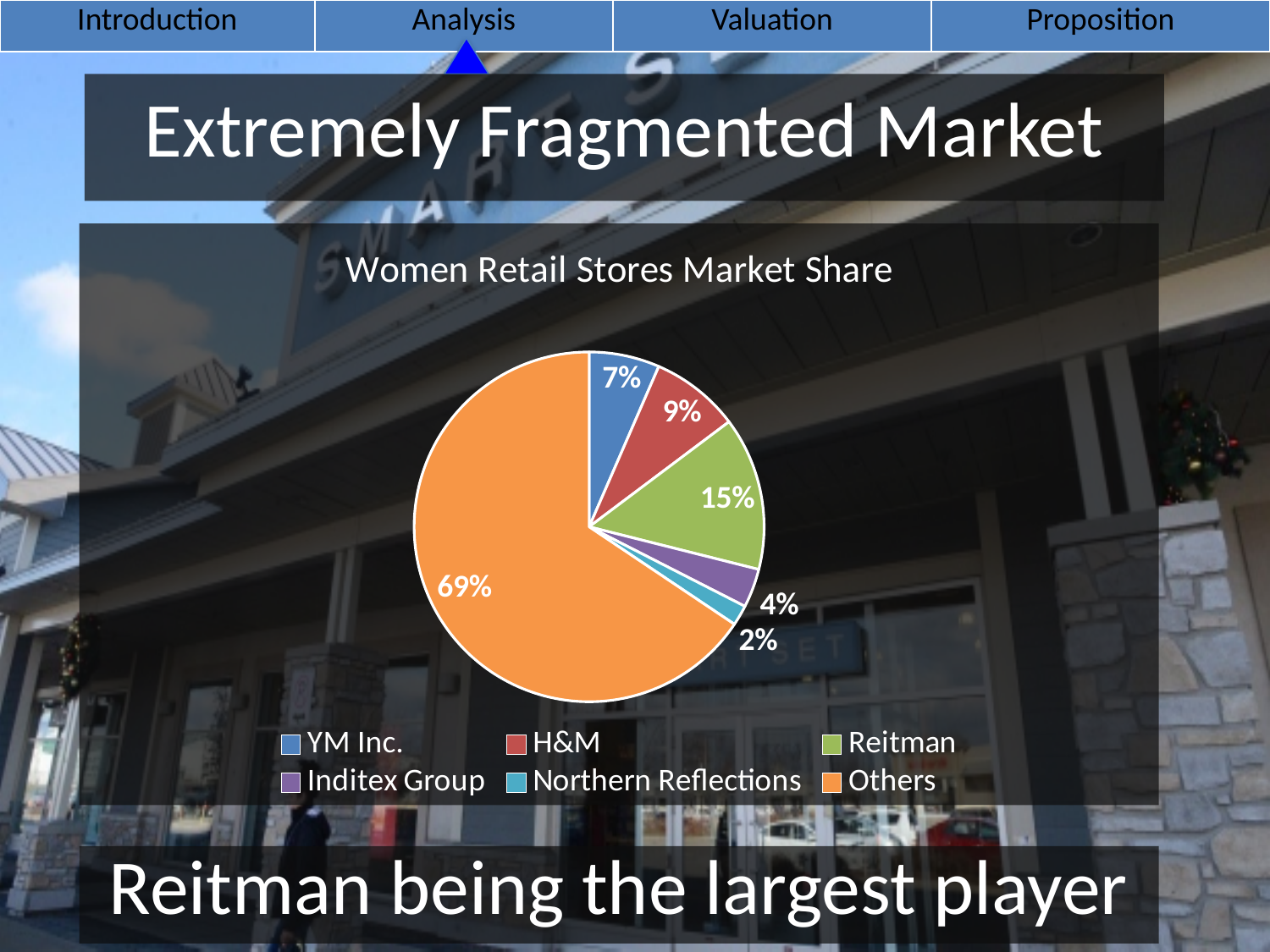
What share of the market is labelled Others? 69% What share of the market does YM Inc. hold? 7% Which category has the smallest slice of the pie? Northern Reflections Which has a larger market share, Inditex Group or YM Inc.? YM Inc. Which named company (excluding Others) has the largest slice of the pie? Reitman How many categories does the legend list? 6 What share of the market does Northern Reflections hold? 2% What share of the market does H&M hold? 9% What is the title of the chart? Women Retail Stores Market Share What share of the market does Reitman hold? 15% What is the difference in market share between Reitman and H&M? 6% What type of chart is shown on the slide? pie chart